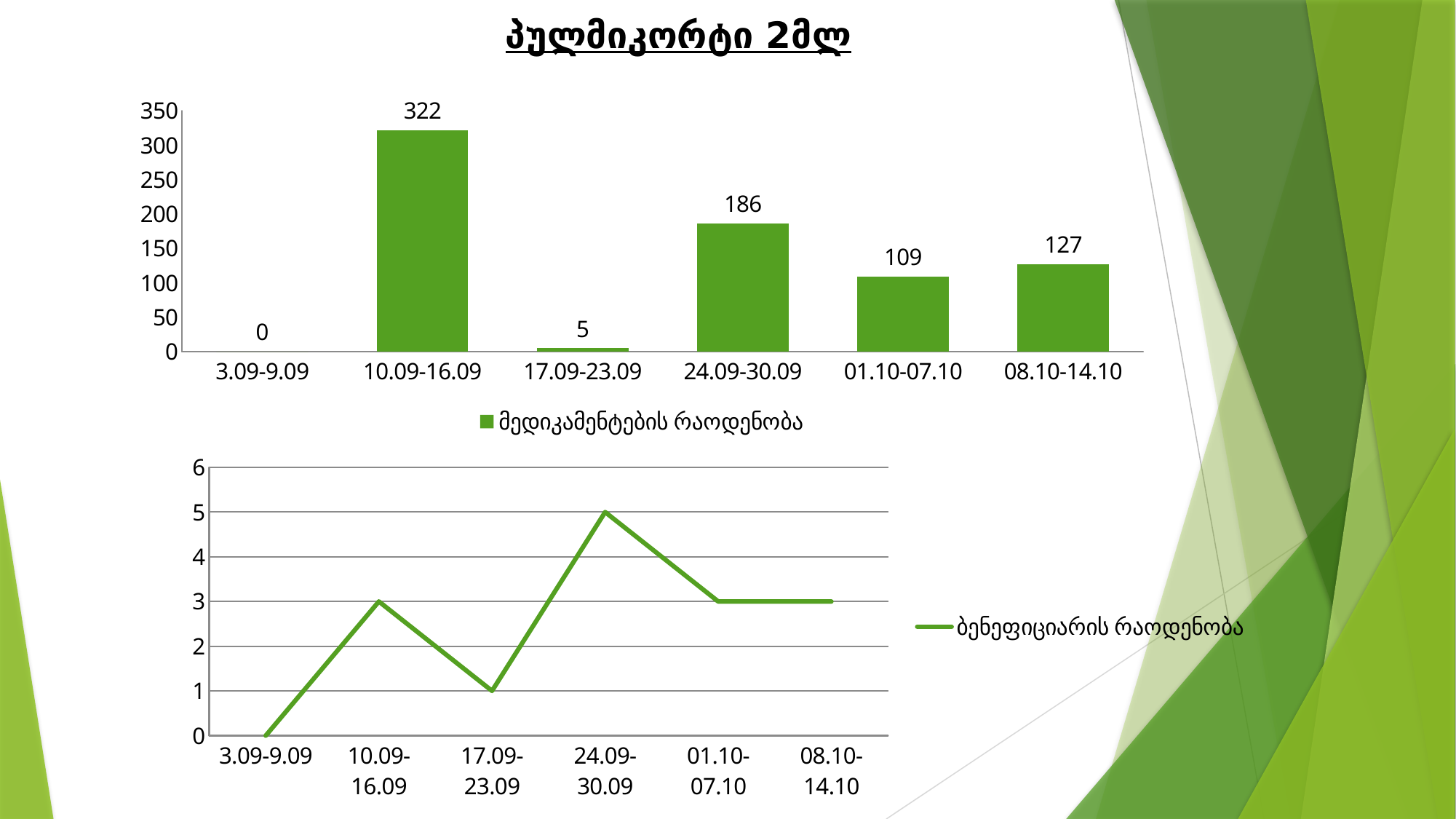
What kind of chart is the top chart on the slide? bar chart In the top bar chart, which is larger: the value for 01.10-07.10 or the value for 08.10-14.10? 08.10-14.10 What is the legend entry of the bottom line chart? ბენეფიციარის რაოდენობა In the top bar chart, what is the value for 10.09-16.09? 322 In the top bar chart, what is the difference between the values for 24.09-30.09 and 08.10-14.10? 59 How many periods are shown on the x axis of the top bar chart? 6 In the bottom line chart, which period has the highest value? 24.09-30.09 In the top bar chart, which period has the highest value? 10.09-16.09 In the top bar chart, what is the value for 01.10-07.10? 109 In the top bar chart, which period has the lowest value? 3.09-9.09 In the bottom line chart, what is the value for 24.09-30.09? 5 In the bottom line chart, what is the value for 17.09-23.09? 1